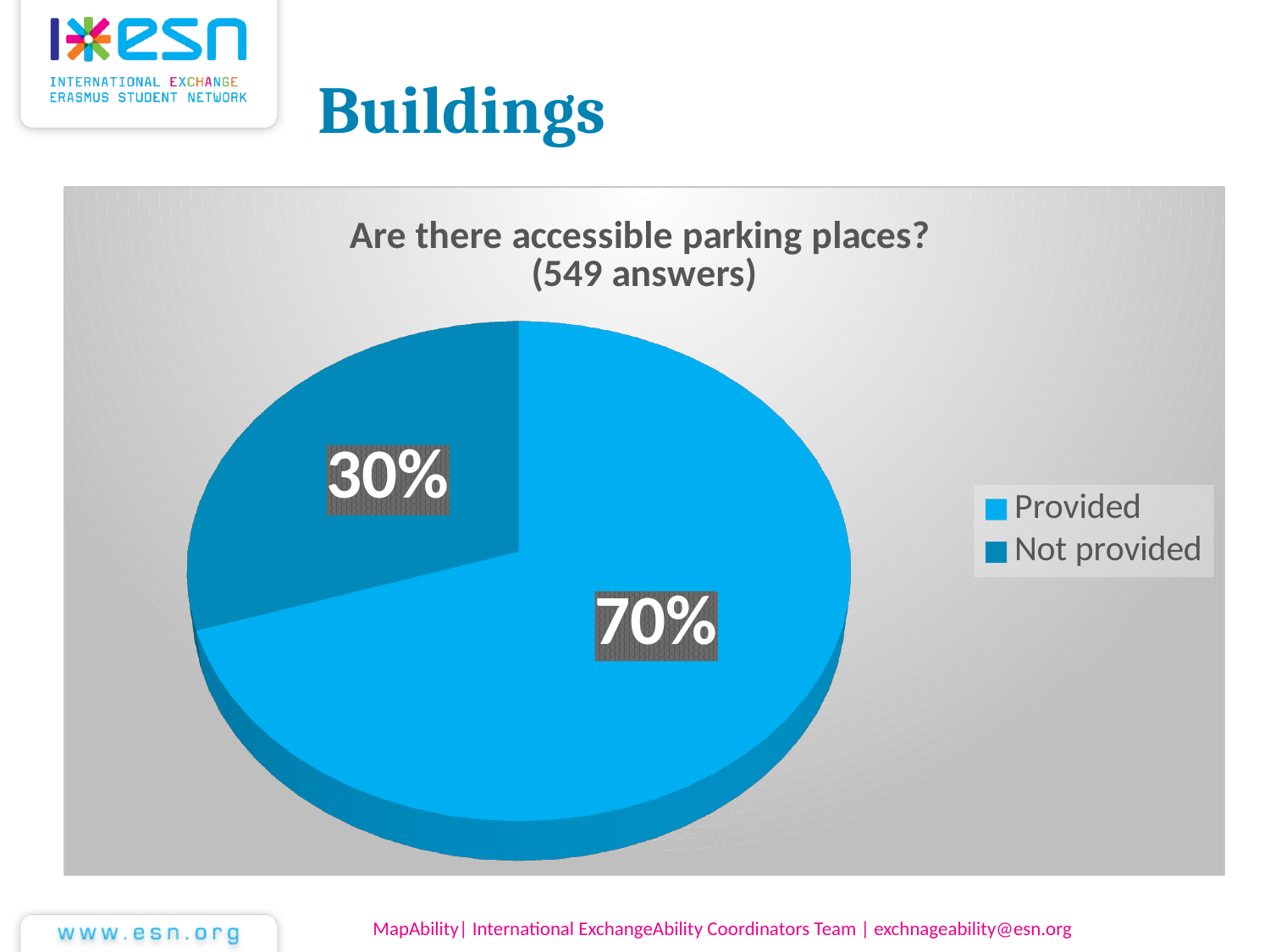
How many slices does the pie chart have? 2 How many entries does the legend list? 2 Which slice of the pie is the largest? Provided What is the title of the chart? Are there accessible parking places? (549 answers) What share of the pie is labelled "Not provided"? 30% How many answers does the chart title say the chart is based on? 549 What share of the pie is labelled "Provided"? 70% Which is larger, the "Provided" slice or the "Not provided" slice? Provided Which slice of the pie is the smallest? Not provided What kind of chart is shown on the slide? pie chart What is the difference in percentage points between the "Provided" and "Not provided" slices? 40 percentage points